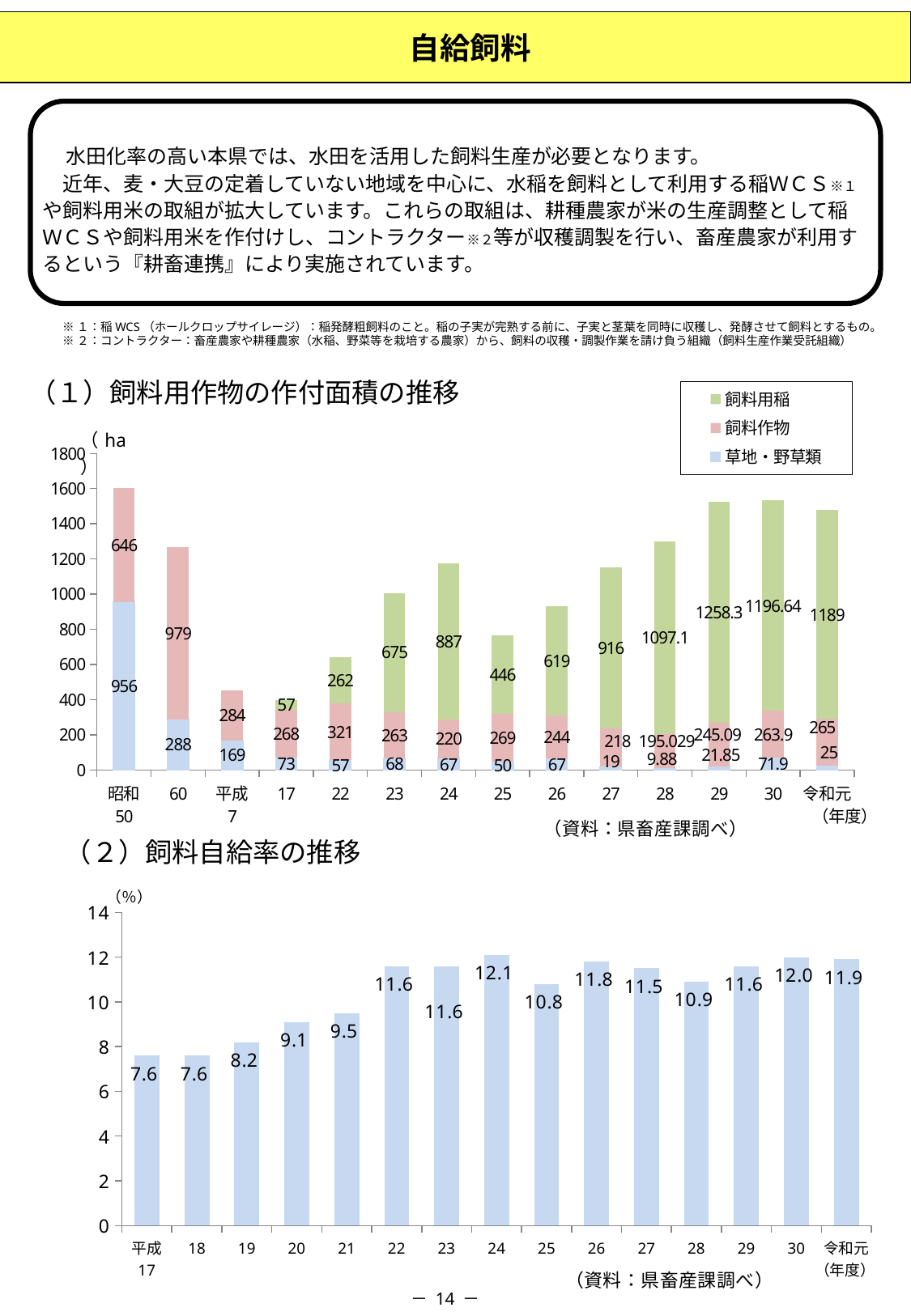
In the chart 飼料用作物の作付面積の推移, how many series does the legend list? 3 In the chart 飼料自給率の推移, how many years are shown on the x axis? 15 In the chart 飼料自給率の推移, what is the value for 平成24? 12.1 In the chart 飼料自給率の推移, which year has the highest value? 平成24 In the chart 飼料用作物の作付面積の推移, which year has the highest value for 飼料用稲? 平成29 In the chart 飼料用作物の作付面積の推移, is the value for 飼料用稲 larger in 平成27 or 平成28? 平成28 In the chart 飼料自給率の推移, what is the difference between the values for 平成24 and 平成17? 4.5 In the chart 飼料用作物の作付面積の推移, what is the value for 草地・野草類 in 昭和50? 956 In the chart 飼料用作物の作付面積の推移, what is the value for 飼料作物 in 平成28? 195.029 In the chart 飼料用作物の作付面積の推移, what is the value for 飼料用稲 in 平成29? 1258.3 In the chart 飼料用作物の作付面積の推移, what is the total of the stacked bar for 令和元? 1479 In the chart 飼料用作物の作付面積の推移, which colour represents 飼料用稲? Green